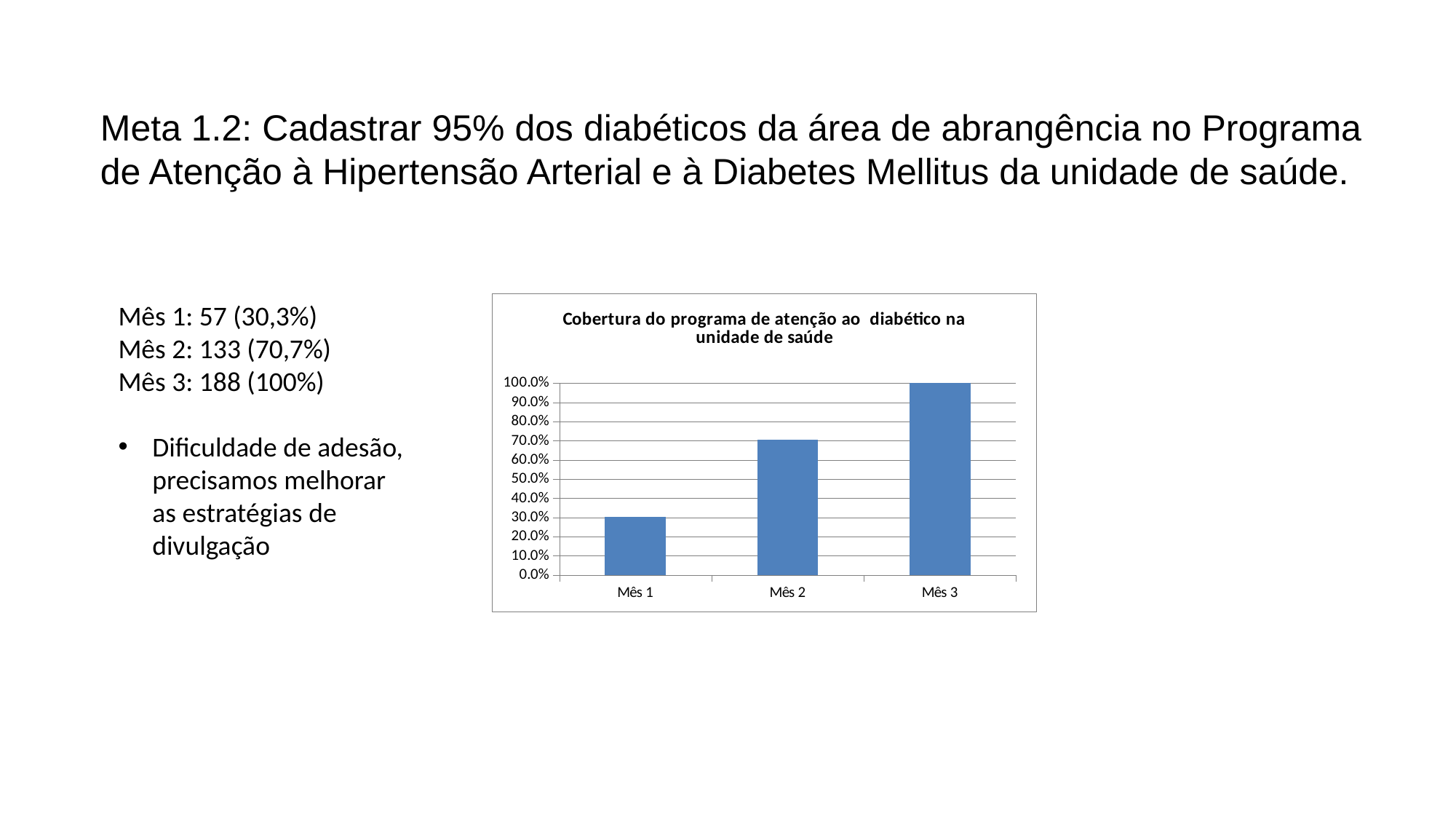
What is the title of the chart? Cobertura do programa de atenção ao diabético na unidade de saúde Do the values rise or fall from Mês 1 to Mês 3? rise Which is larger, the value for Mês 1 or the value for Mês 2? Mês 2 What kind of chart is shown on the slide? bar chart How many categories are shown on the x axis of the chart? 3 What is the coverage value for Mês 3 in the chart? 100.0% Is the value for Mês 1 greater or less than 20.0%? greater Is the value for Mês 2 greater or less than 60.0%? greater Is the value for Mês 1 greater or less than 40.0%? less What is the highest tick value shown on the y axis of the chart? 100.0% Which month has the lowest coverage in the chart? Mês 1 Which month has the highest coverage in the chart? Mês 3